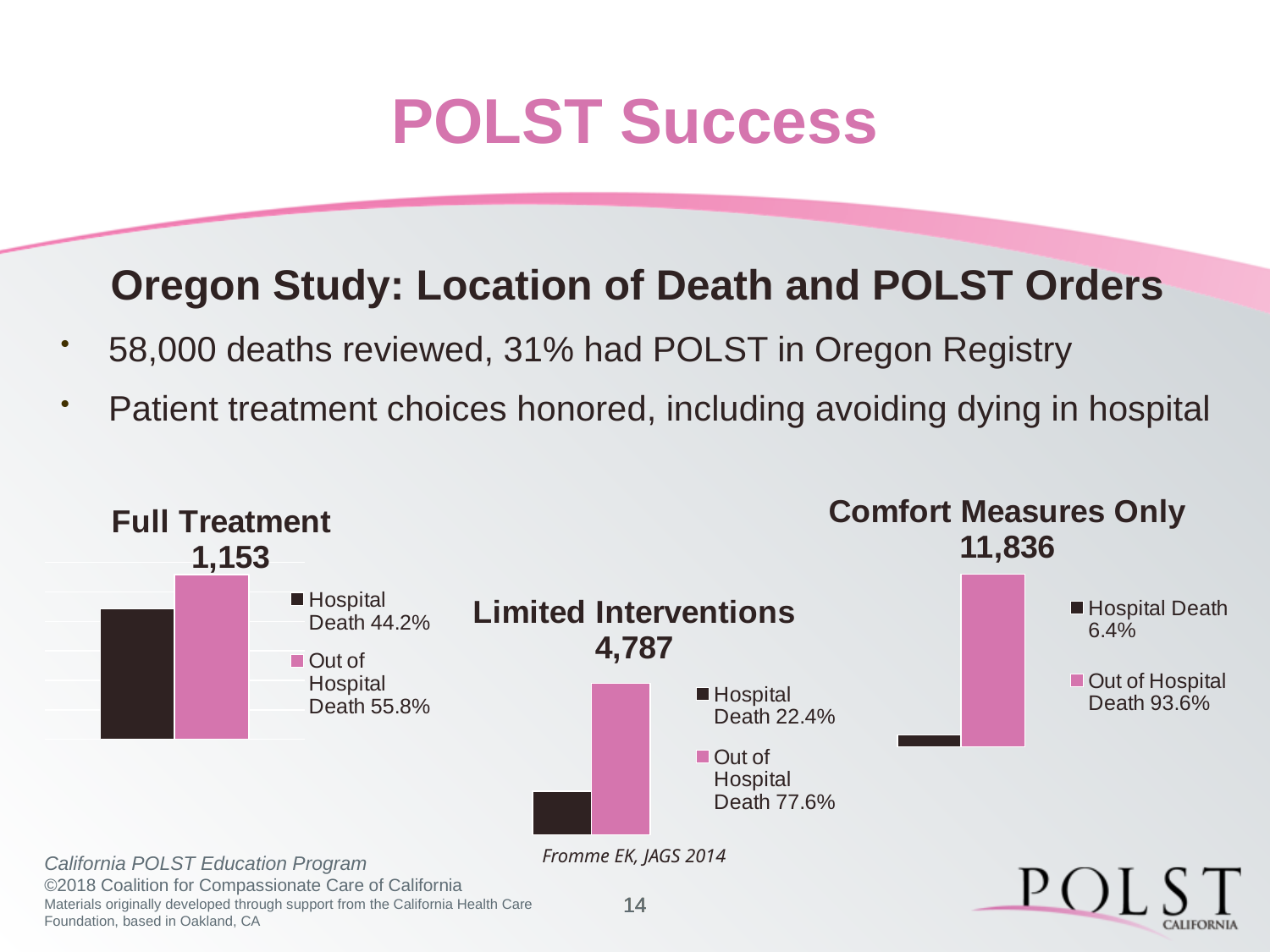
In the Limited Interventions chart, what percentage is shown for Hospital Death? 22.4% In the Comfort Measures Only chart, what is the difference between the Out of Hospital Death and Hospital Death percentages? 87.2% In the Full Treatment chart, what is the difference between the Out of Hospital Death and Hospital Death percentages? 11.6% In the Full Treatment chart, is the Hospital Death bar or the Out of Hospital Death bar taller? Out of Hospital Death In the Full Treatment chart, what percentage is shown for Hospital Death? 44.2% How many series does the legend of the Limited Interventions chart list? 2 In the Comfort Measures Only chart, what percentage is shown for Out of Hospital Death? 93.6% In the Comfort Measures Only chart, which category has the shorter bar? Hospital Death In the Limited Interventions chart, which category has the taller bar? Out of Hospital Death What type of chart is the Comfort Measures Only chart? Bar chart In the Comfort Measures Only chart, what percentage is shown for Hospital Death? 6.4% In the Full Treatment chart, what percentage is shown for Out of Hospital Death? 55.8%